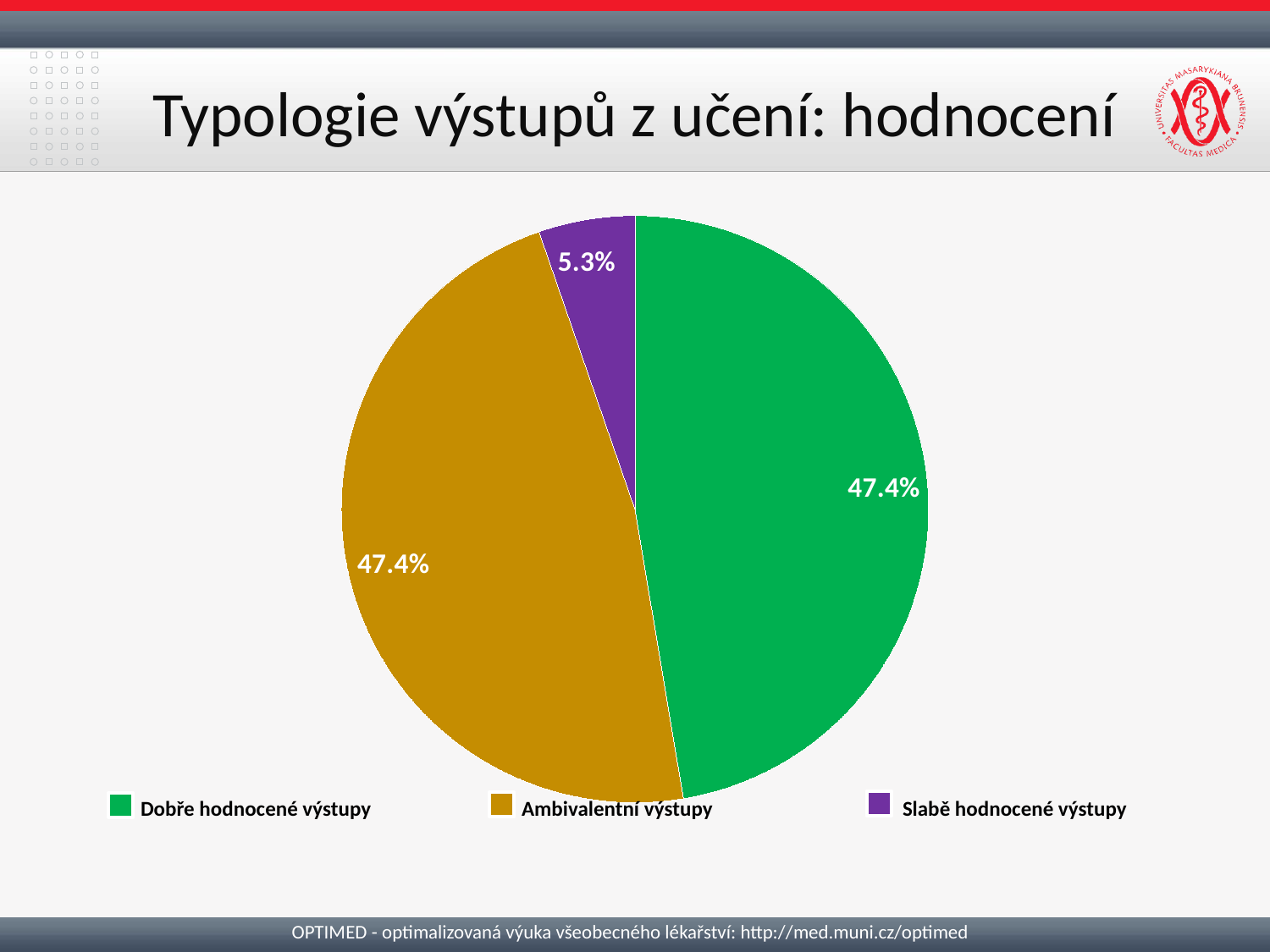
What share of the pie does "Dobře hodnocené výstupy" represent? 47.4% Which category has the smallest slice of the pie? Slabě hodnocené výstupy What is the title of the slide containing the pie chart? Typologie výstupů z učení: hodnocení What kind of chart is shown on the slide? pie chart What colour is the slice for "Slabě hodnocené výstupy"? purple How many slices does the pie chart have? 3 Do "Dobře hodnocené výstupy" and "Ambivalentní výstupy" have the same share of the pie? yes What is the difference in percentage points between "Ambivalentní výstupy" and "Slabě hodnocené výstupy"? 42.1 Which is larger: the slice for "Dobře hodnocené výstupy" or the slice for "Slabě hodnocené výstupy"? Dobře hodnocené výstupy How many entries does the legend list? 3 What share of the pie does "Ambivalentní výstupy" represent? 47.4% What share of the pie does "Slabě hodnocené výstupy" represent? 5.3%